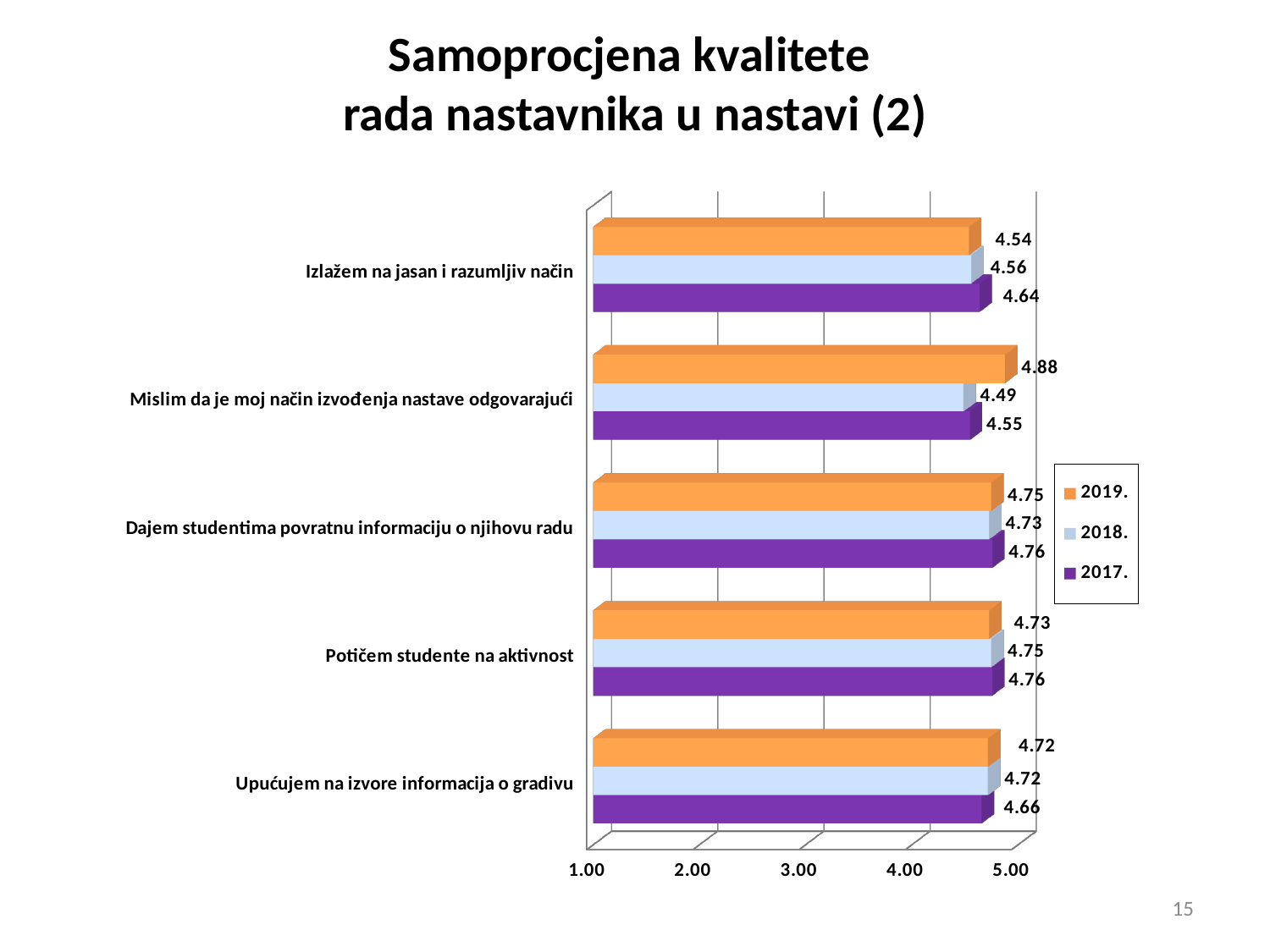
Which category has the lowest value for 2018.? Mislim da je moj način izvođenja nastave odgovarajući For "Izlažem na jasan i razumljiv način", which is larger: the 2017. value or the 2019. value? 2017. Is the 2018. value for "Mislim da je moj način izvođenja nastave odgovarajući" greater or less than 4.00? greater What kind of chart is shown on the slide? bar chart Which category has the highest value for 2019.? Mislim da je moj način izvođenja nastave odgovarajući How many categories are shown on the chart? 5 How many series does the legend list? 3 What is the difference between the 2019. and 2018. values for "Mislim da je moj način izvođenja nastave odgovarajući"? 0.39 What is the value for 2019. for "Mislim da je moj način izvođenja nastave odgovarajući"? 4.88 Which series is shown in orange in the legend? 2019. What is the value for 2018. for "Upućujem na izvore informacija o gradivu"? 4.72 What is the value for 2017. for "Izlažem na jasan i razumljiv način"? 4.64